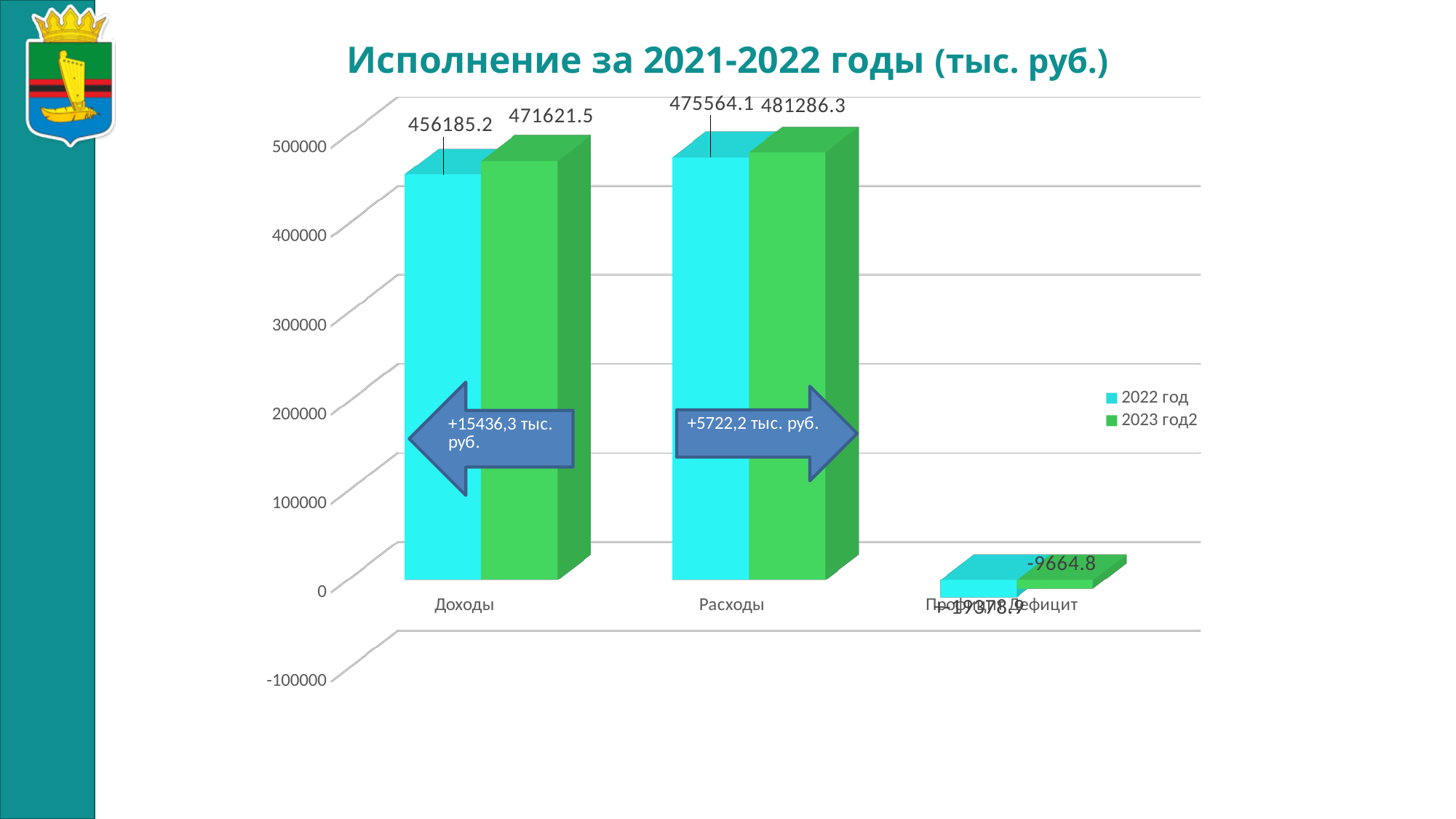
What is the difference between the 2023 год2 and 2022 год values for Расходы? 5722.2 What is the title of the chart? Исполнение за 2021-2022 годы (тыс. руб.) Which is larger for the 2022 год series: Доходы or Расходы? Расходы What is the value of the green (2023 год2) bar for the rightmost category? -9664.8 What is the value for Доходы in the 2023 год2 series? 471621.5 Which category has the highest value in the 2023 год2 series? Расходы What kind of chart is shown on the slide? Bar chart How many series does the legend list? 2 What is the value for Доходы in the 2022 год series? 456185.2 What is the value for Расходы in the 2022 год series? 475564.1 What is the value for Расходы in the 2023 год2 series? 481286.3 What is the difference between the 2023 год2 and 2022 год values for Доходы? 15436.3